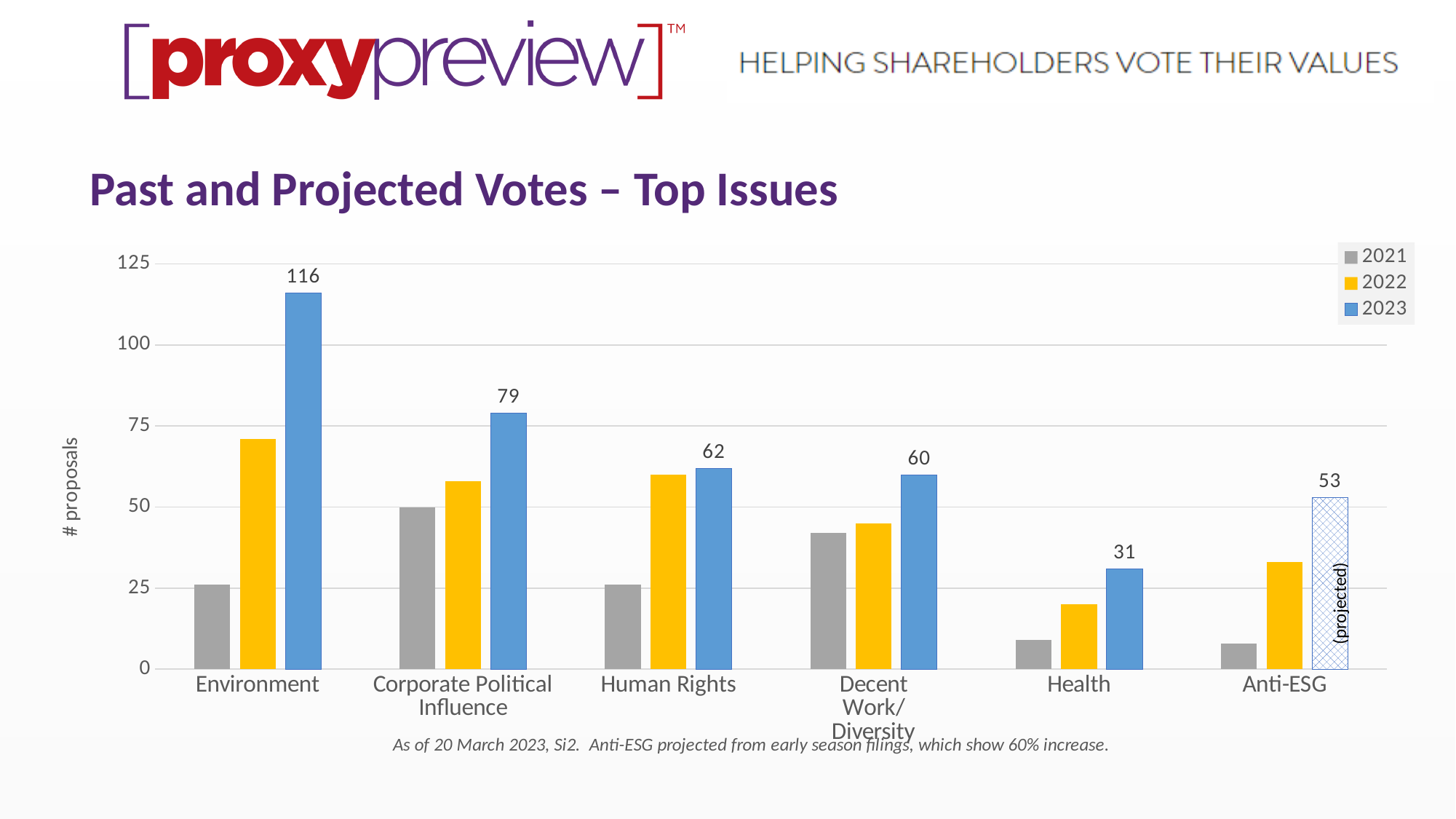
What is the projected 2023 value for Anti-ESG? 53 Which is larger, the 2023 value for Human Rights or the 2023 value for Decent Work/Diversity? Human Rights How many series does the legend list? 3 What is the 2023 value for Environment? 116 Is the 2022 value for Environment greater or less than 50? greater What kind of chart is shown on the slide? Bar chart Is the 2021 value for Health greater or less than 25? less What is the 2023 value for Health? 31 Which category has the lowest 2023 value? Health Which category has the highest 2023 value? Environment What is the 2023 value for Corporate Political Influence? 79 What is the difference between the 2023 values for Environment and Corporate Political Influence? 37